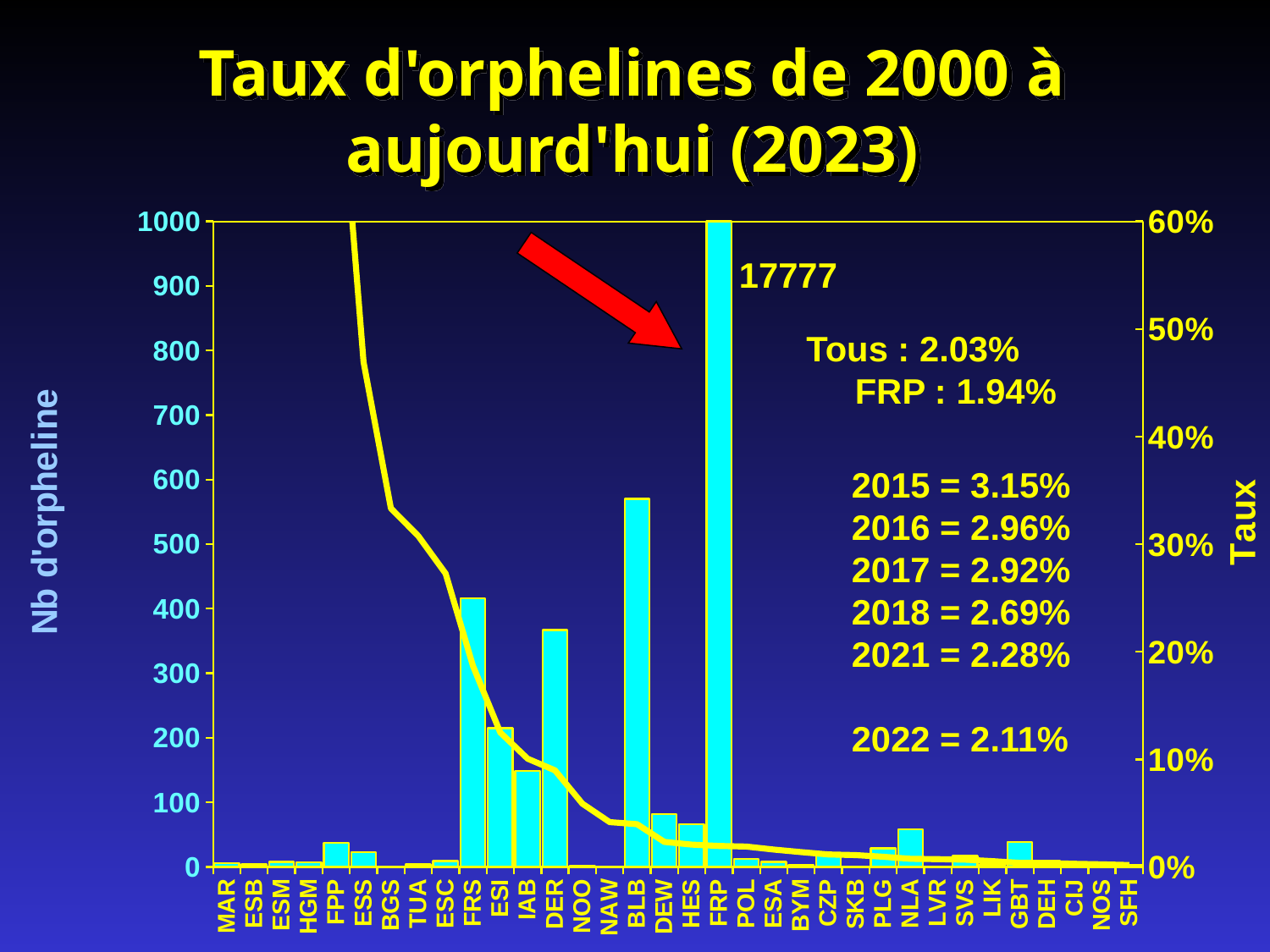
Which bar is taller, BLB or DER? BLB What overall rate is annotated for 'Tous' on the chart? 2.03% Is the bar value for IAB greater or less than 200? less Which category has the highest bar? FRP Is the bar value for DER greater or less than 300? greater How many categories are shown along the x axis? 34 Does the yellow line rise or fall from left to right along the x axis? fall Is the bar value for BLB greater or less than 500? greater What kind of chart is shown on the slide? bar chart with a line What value is labelled on the FRP bar? 17777 What is the title of the chart? Taux d'orphelines de 2000 à aujourd'hui (2023)